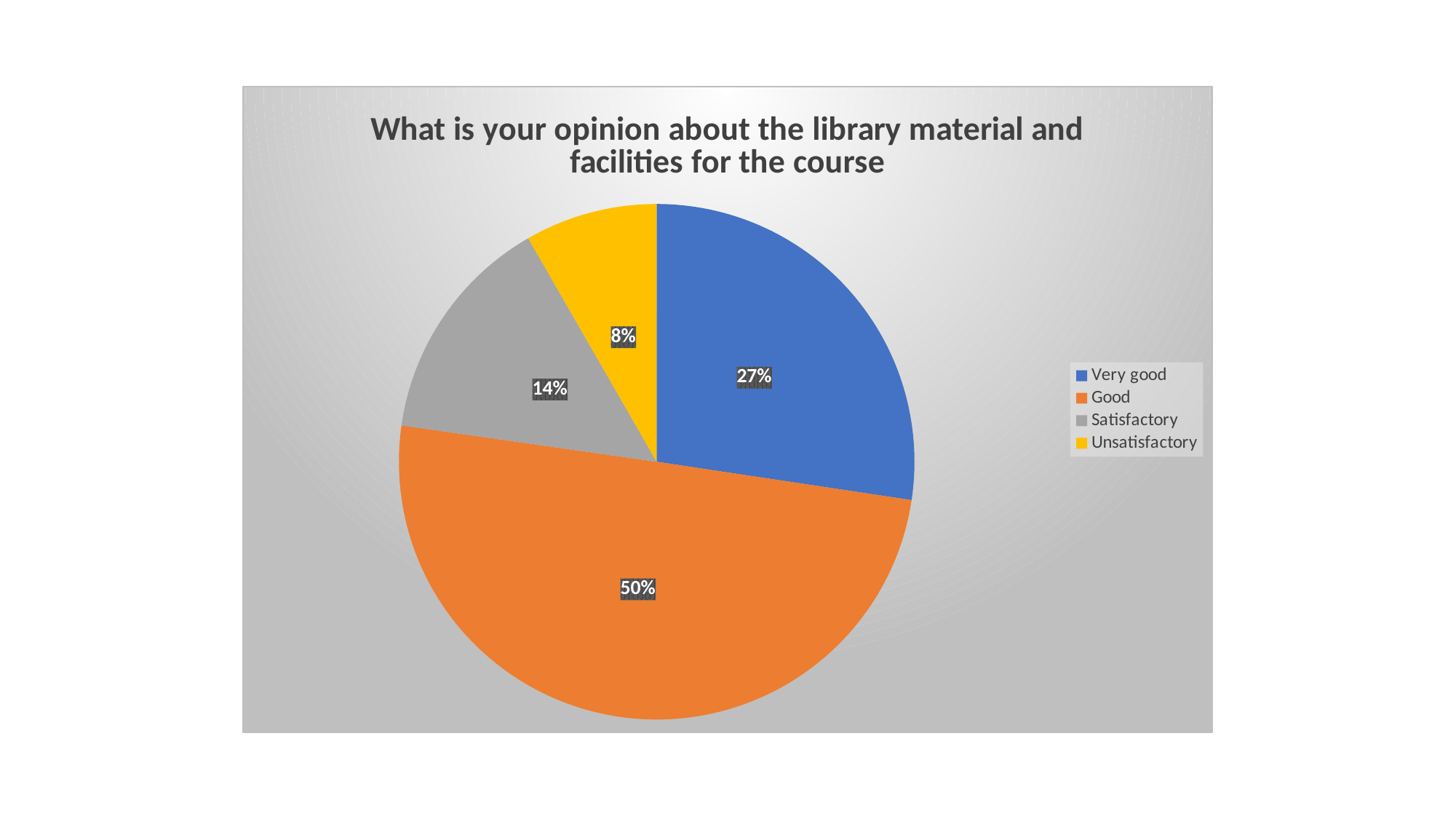
Which slice is larger, Satisfactory or Unsatisfactory? Satisfactory What percentage of respondents rated the library material and facilities as Very good? 27% What percentage of respondents rated the library material and facilities as Satisfactory? 14% What percentage of respondents rated the library material and facilities as Good? 50% How many categories does the pie chart show? 4 What is the difference in percentage points between the Good and Very good slices? 23 What kind of chart is shown on the slide? Pie chart What percentage of respondents rated the library material and facilities as Unsatisfactory? 8% Which opinion category has the largest share of the pie? Good What is the title of the chart? What is your opinion about the library material and facilities for the course What colour is the Satisfactory slice? Grey Which opinion category has the smallest share of the pie? Unsatisfactory